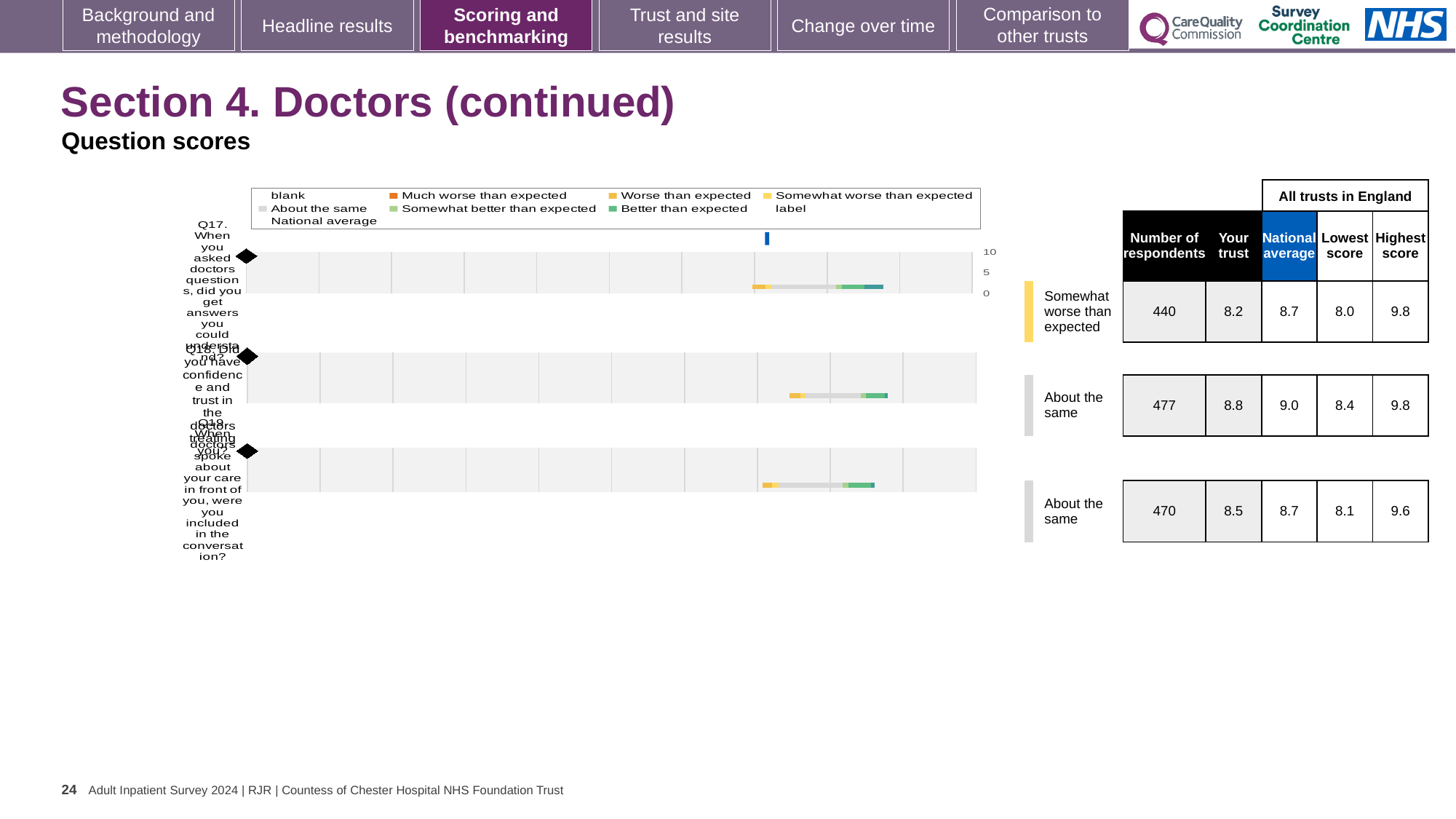
According to the table, what is the highest score among all trusts in England for Q19? 9.6 What benchmark category is shown next to Q17? Somewhat worse than expected According to the table, what is the national average for Q18? 9.0 According to the table, how many respondents answered Q19? 470 Which has the larger 'Your trust' score, Q17 or Q18? Q18 Which question has the highest number of respondents in the table? Q18 Which question has the lowest 'Your trust' score in the table? Q17 What is the difference between the national average and the 'Your trust' score for Q18? 0.2 According to the table, what is the 'Your trust' score for Q17? 8.2 According to the table, what is the lowest score among all trusts in England for Q17? 8.0 What kind of chart is shown on the slide? bar chart How many questions (categories) are plotted in the chart? 3